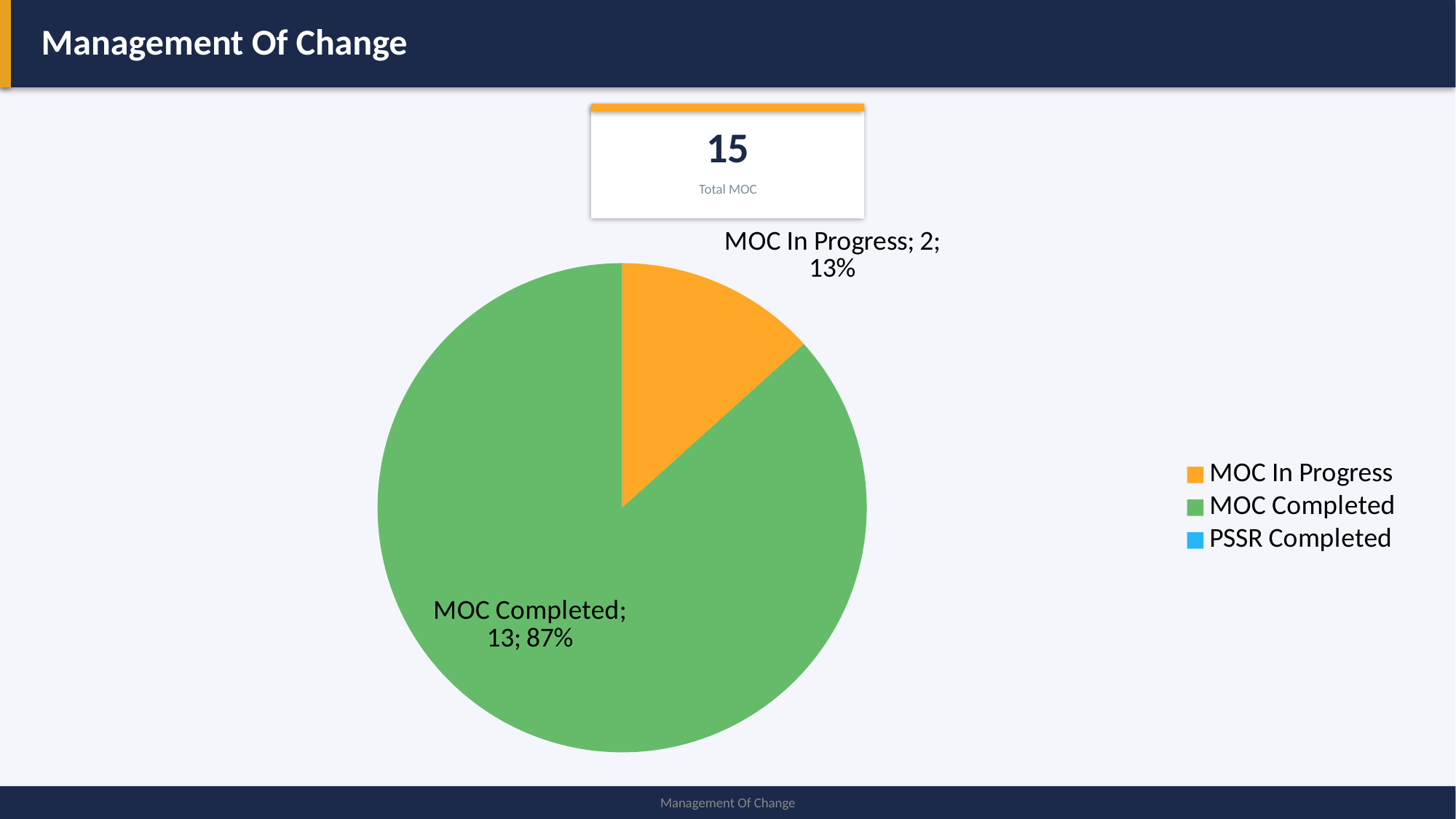
Which legend entry has no visible slice in the pie? PSSR Completed Which of the two labelled slices is larger, MOC In Progress or MOC Completed? MOC Completed How many MOC In Progress are shown in the pie chart? 2 Which category has the largest slice of the pie? MOC Completed How many entries does the legend list? 3 What share of the pie does MOC Completed represent? 87% What is the difference between the MOC Completed count and the MOC In Progress count? 11 What colour is the MOC Completed slice? green What is the Total MOC value shown in the box above the pie chart? 15 How many MOC Completed are shown in the pie chart? 13 What kind of chart is shown on the slide? pie chart What share of the pie does MOC In Progress represent? 13%